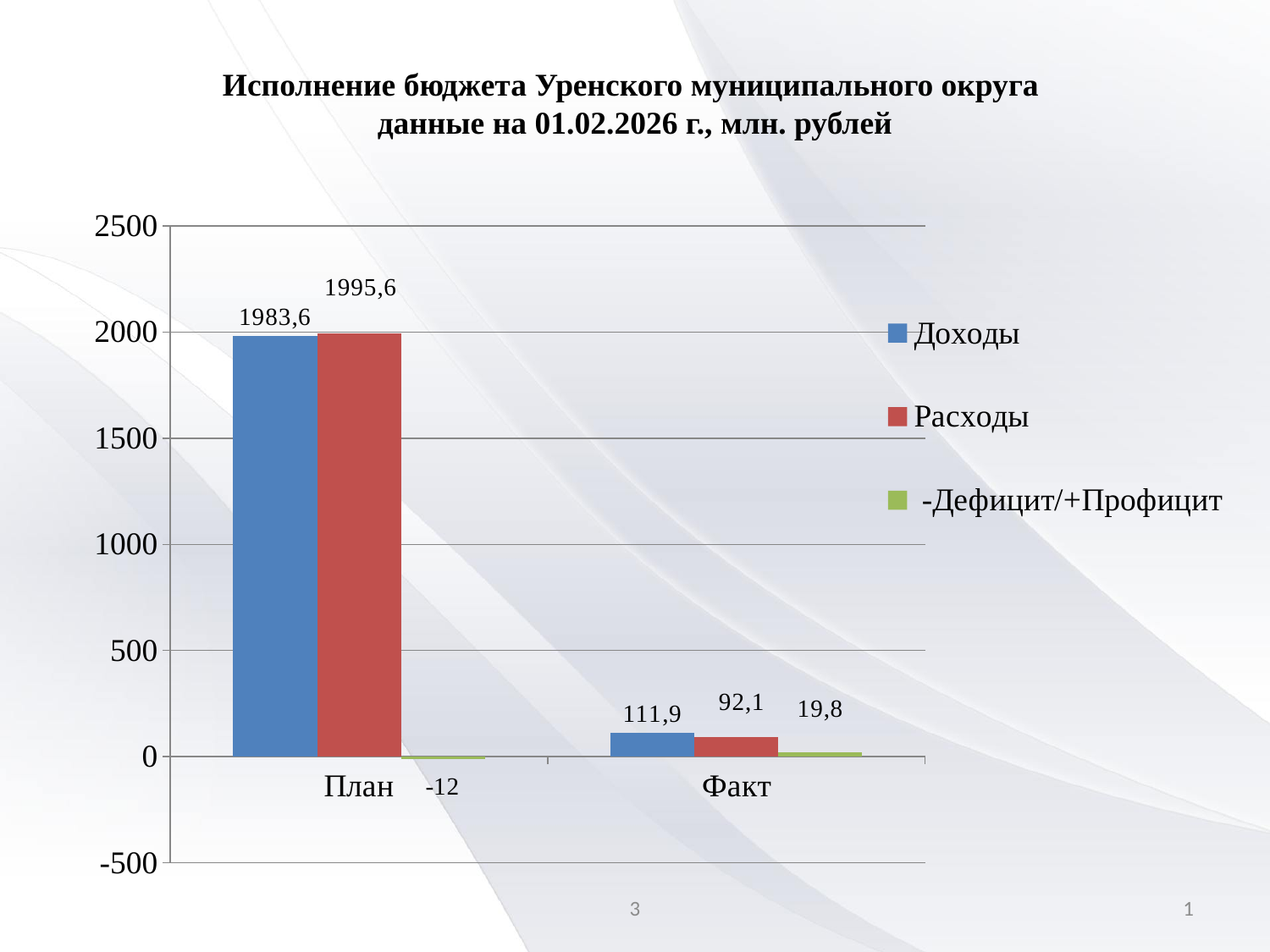
Which is larger: Доходы for План or Доходы for Факт? Доходы for План What is the value of -Дефицит/+Профицит for План? -12 How many categories are shown on the x axis? 2 What is the value of Доходы for План? 1983,6 What kind of chart is shown on the slide? Bar chart Which series has the lowest value in the Факт category? -Дефицит/+Профицит What is the value of Расходы for Факт? 92,1 Which series has the highest value in the План category? Расходы What is the difference between Доходы and Расходы for Факт? 19,8 How many series does the legend list? 3 What is the difference between Расходы and Доходы for План? 12 What is the value of -Дефицит/+Профицит for Факт? 19,8